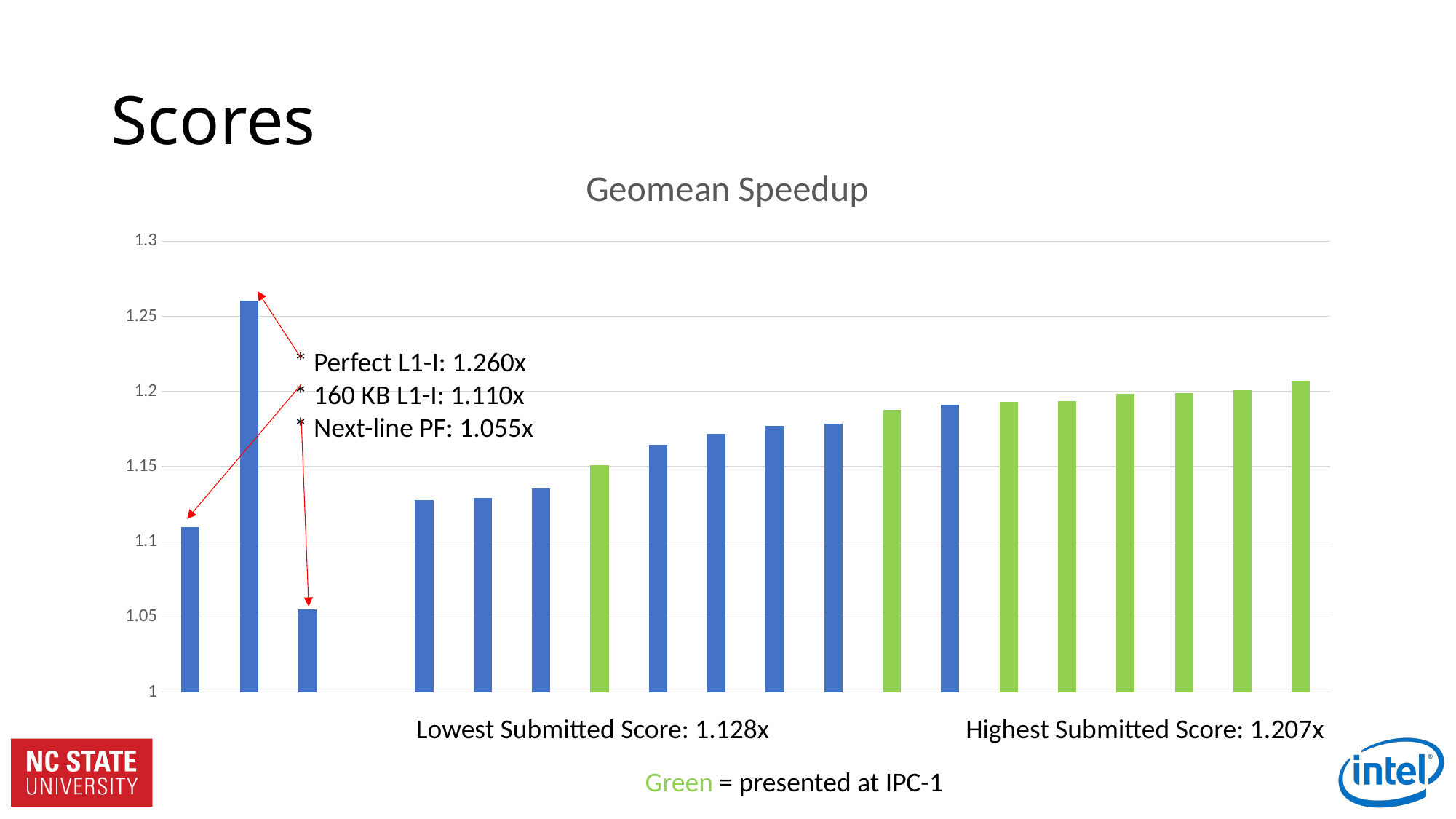
Is the value of the first (leftmost) green bar greater or less than 1.2? less Of the three annotated reference configurations (Perfect L1-I, 160 KB L1-I, Next-line PF), which has the lowest speedup? Next-line PF What geomean speedup is given for 160 KB L1-I? 1.110x What is the highest submitted score shown on the chart? 1.207x What is the title of the chart? Geomean Speedup According to the slide, what do the green bars indicate? presented at IPC-1 Which is larger, the Perfect L1-I speedup or the highest submitted score? Perfect L1-I What kind of chart is shown on the slide? bar chart What is the difference between the highest and lowest submitted scores? 0.079x What geomean speedup is given for Next-line PF? 1.055x What is the lowest submitted score shown on the chart? 1.128x What geomean speedup is given for Perfect L1-I? 1.260x